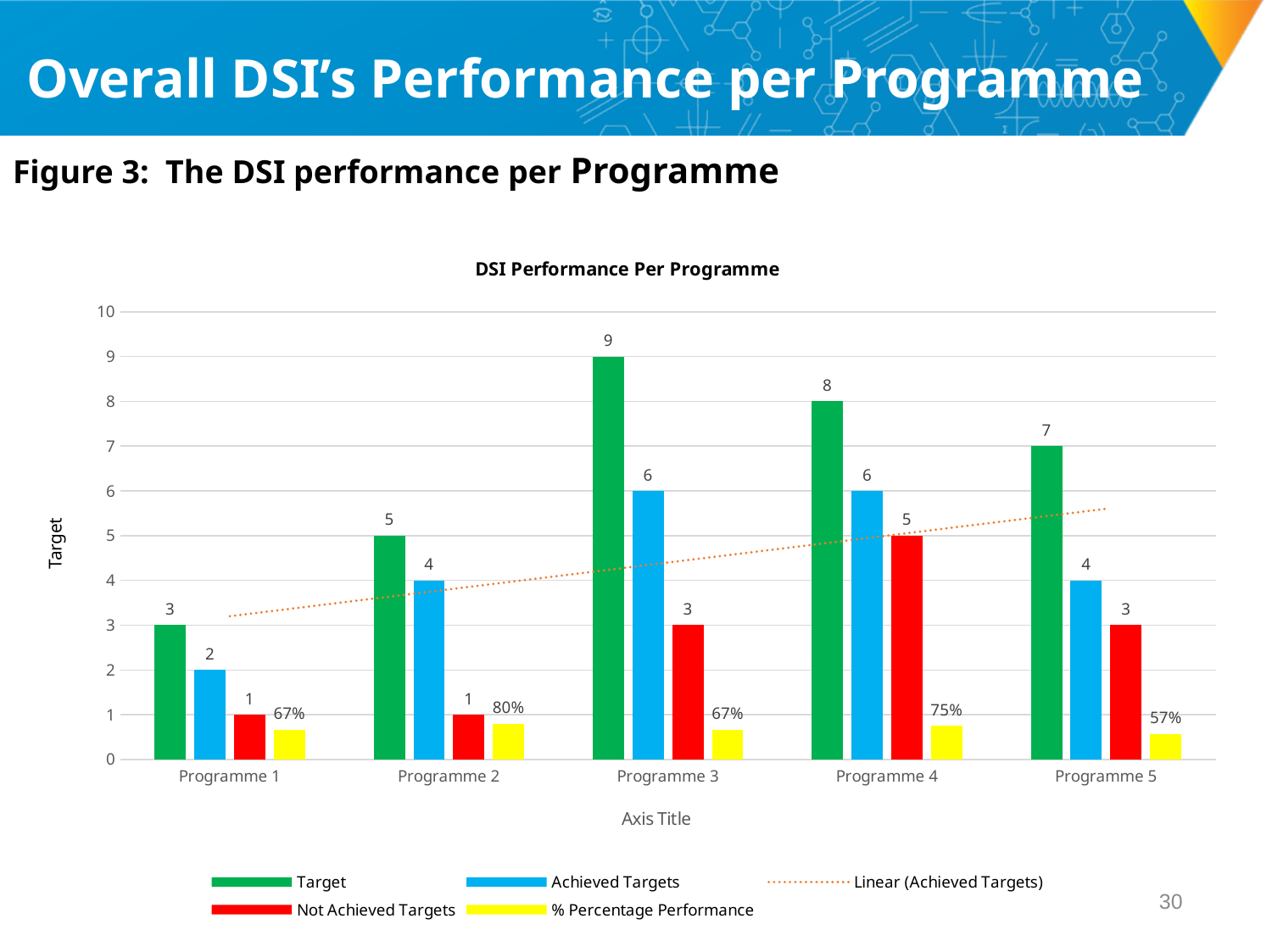
What is the Achieved Targets value for Programme 5? 4 What is the difference between the Target and Achieved Targets values for Programme 4? 2 Which programme has the lowest % Percentage Performance? Programme 5 What is the Not Achieved Targets value for Programme 4? 5 What is the Target value for Programme 3? 9 What is the title of the chart? DSI Performance Per Programme Which is larger, the Not Achieved Targets value for Programme 4 or for Programme 5? Programme 4 Which programme has the highest Target value? Programme 3 What kind of chart is shown on the slide? Bar chart How many entries does the legend list? 5 How many programmes are shown on the x axis? 5 What is the % Percentage Performance for Programme 2? 80%